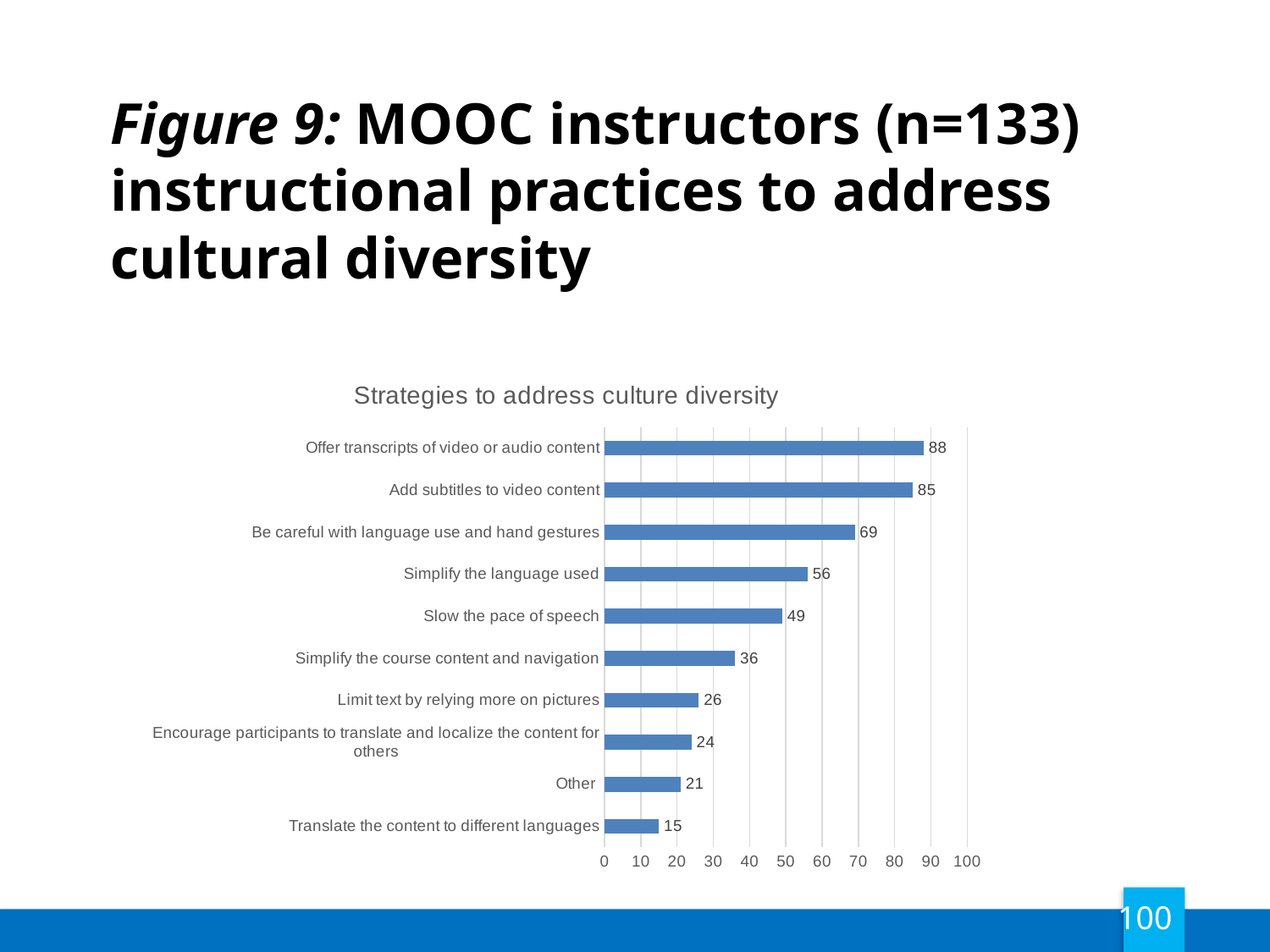
Which strategy has the lowest value? Translate the content to different languages Which is larger, the value for "Limit text by relying more on pictures" or the value for "Encourage participants to translate and localize the content for others"? Limit text by relying more on pictures What is the title of the chart? Strategies to address culture diversity What kind of chart is shown on the slide? bar chart How many strategies are shown in the chart? 10 Which strategy has the highest value? Offer transcripts of video or audio content What is the difference between the values for "Simplify the language used" and "Simplify the course content and navigation"? 20 What is the difference between the values for "Offer transcripts of video or audio content" and "Add subtitles to video content"? 3 Is the value for "Be careful with language use and hand gestures" greater or less than 60? greater What is the value for "Slow the pace of speech"? 49 What is the value for "Add subtitles to video content"? 85 What is the value for "Other"? 21